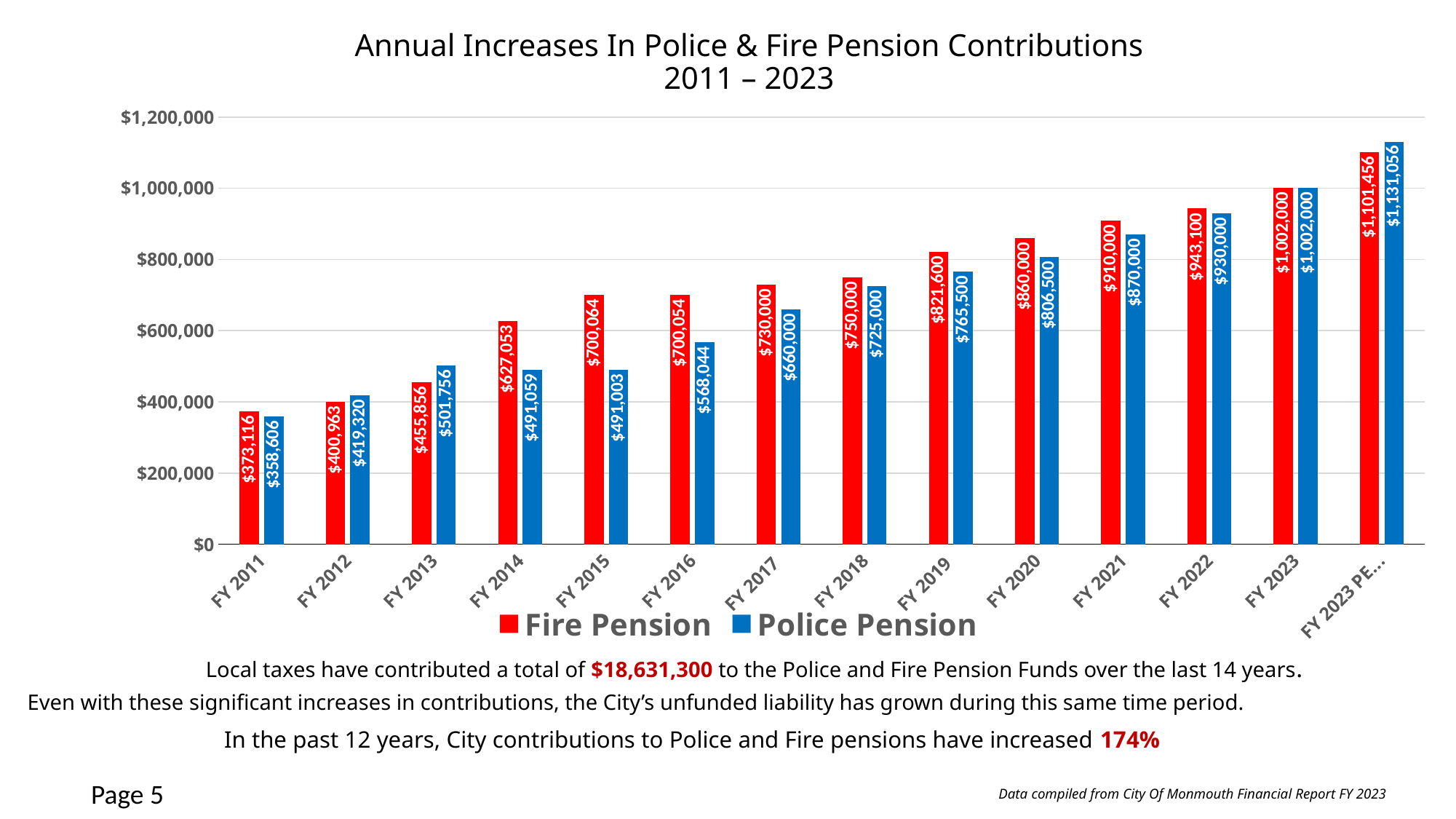
What is the Fire Pension contribution for FY 2014? $627,053 How many series does the legend list? 2 How many fiscal year categories are shown on the x axis? 14 What is the Police Pension contribution for FY 2016? $568,044 What is the Fire Pension contribution for FY 2023? $1,002,000 What kind of chart is shown on the slide? bar chart Is the Police Pension contribution for FY 2019 greater or less than $800,000? less By how much did the Police Pension contribution increase from FY 2022 to FY 2023? $72,000 In FY 2013, which is larger, the Fire Pension or the Police Pension contribution? Police Pension Which fiscal year has the lowest Police Pension contribution? FY 2011 Which fiscal year has the lowest Fire Pension contribution? FY 2011 What is the difference between the Fire Pension and Police Pension contributions in FY 2015? $209,061